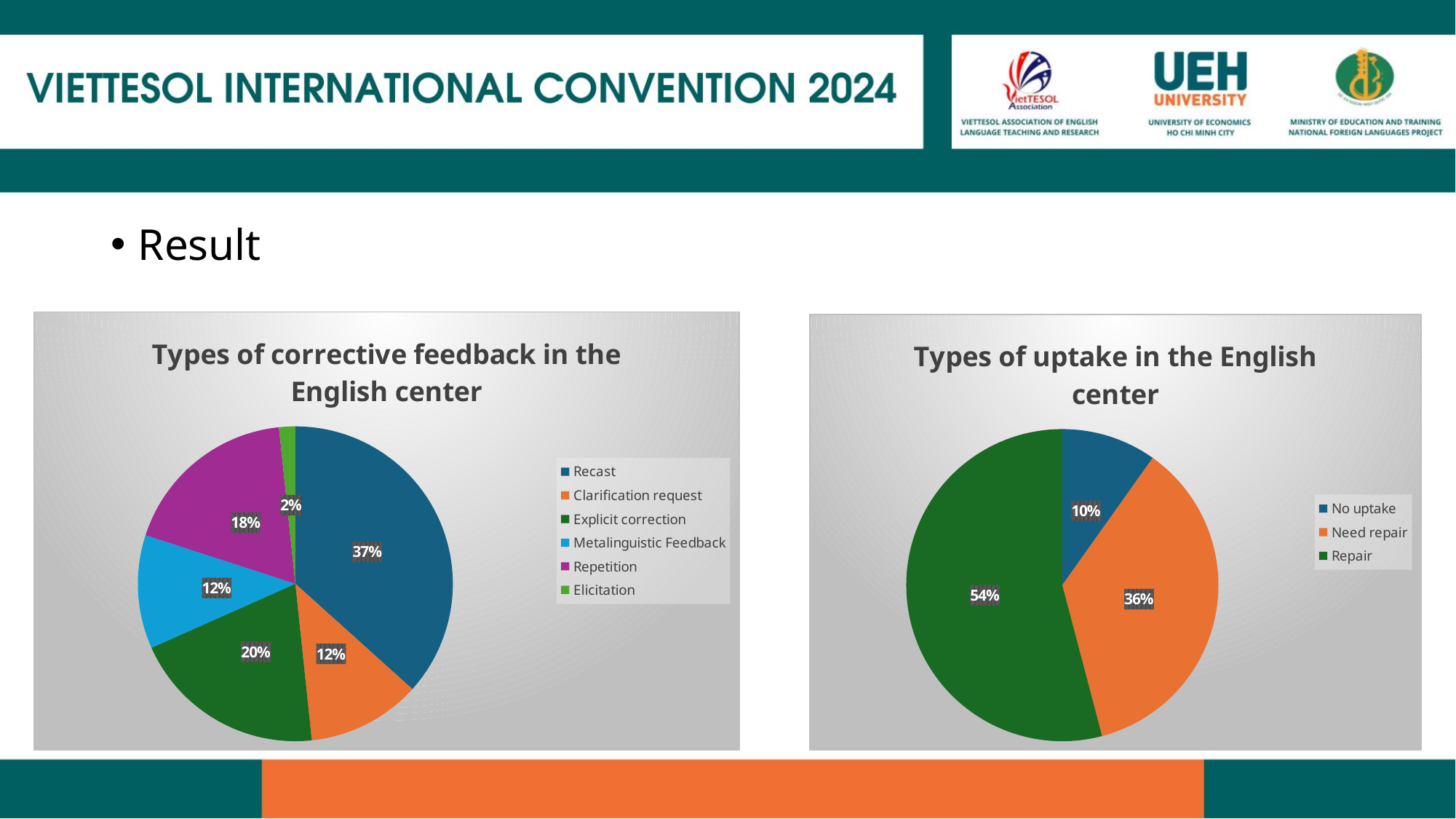
In the 'Types of corrective feedback in the English center' chart, what is the difference between the shares of Explicit correction and Repetition? 2% In the 'Types of corrective feedback in the English center' chart, what share does Recast have? 37% In the 'Types of corrective feedback in the English center' chart, what share does Repetition have? 18% In the 'Types of uptake in the English center' chart, what colour is the Repair slice? Green In the 'Types of corrective feedback in the English center' chart, which type of feedback has the largest share? Recast In the 'Types of corrective feedback in the English center' chart, which type of feedback has the smallest share? Elicitation In the 'Types of corrective feedback in the English center' chart, how many categories does the legend list? 6 What kind of chart is the 'Types of uptake in the English center' chart? Pie chart In the 'Types of uptake in the English center' chart, what share does Need repair have? 36% In the 'Types of uptake in the English center' chart, which category has the largest share? Repair In the 'Types of uptake in the English center' chart, what is the difference between the shares of Repair and No uptake? 44% In the 'Types of corrective feedback in the English center' chart, which is larger: Explicit correction or Metalinguistic Feedback? Explicit correction